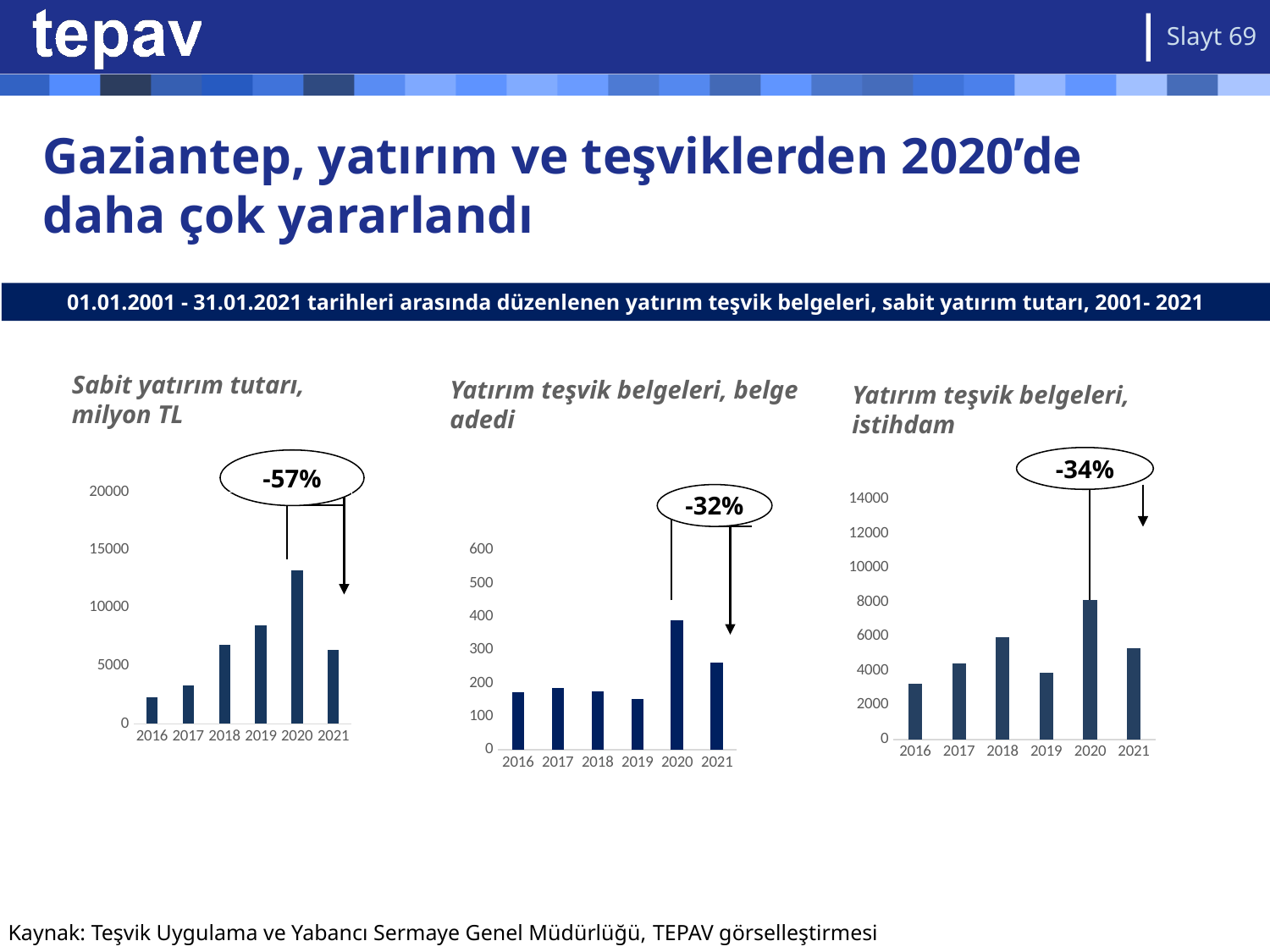
In the 'Yatırım teşvik belgeleri, istihdam' chart, which year has the lowest value? 2016 In the 'Yatırım teşvik belgeleri, istihdam' chart, is the value for 2020 greater or less than 6000? greater In the 'Sabit yatırım tutarı, milyon TL' chart, is the value for 2020 greater or less than 10000? greater How many years are shown on the x axis of the 'Sabit yatırım tutarı, milyon TL' chart? 6 In the 'Yatırım teşvik belgeleri, belge adedi' chart, which year has the highest value? 2020 In the 'Sabit yatırım tutarı, milyon TL' chart, which year has the lowest value? 2016 In the 'Yatırım teşvik belgeleri, istihdam' chart, which year has the highest value? 2020 In the 'Sabit yatırım tutarı, milyon TL' chart, which year has the highest value? 2020 What percentage change is annotated above the 'Yatırım teşvik belgeleri, istihdam' chart? -34% In the 'Yatırım teşvik belgeleri, belge adedi' chart, is the value for 2021 larger or smaller than the value for 2019? larger In the 'Sabit yatırım tutarı, milyon TL' chart, is the value for 2016 greater or less than 5000? less